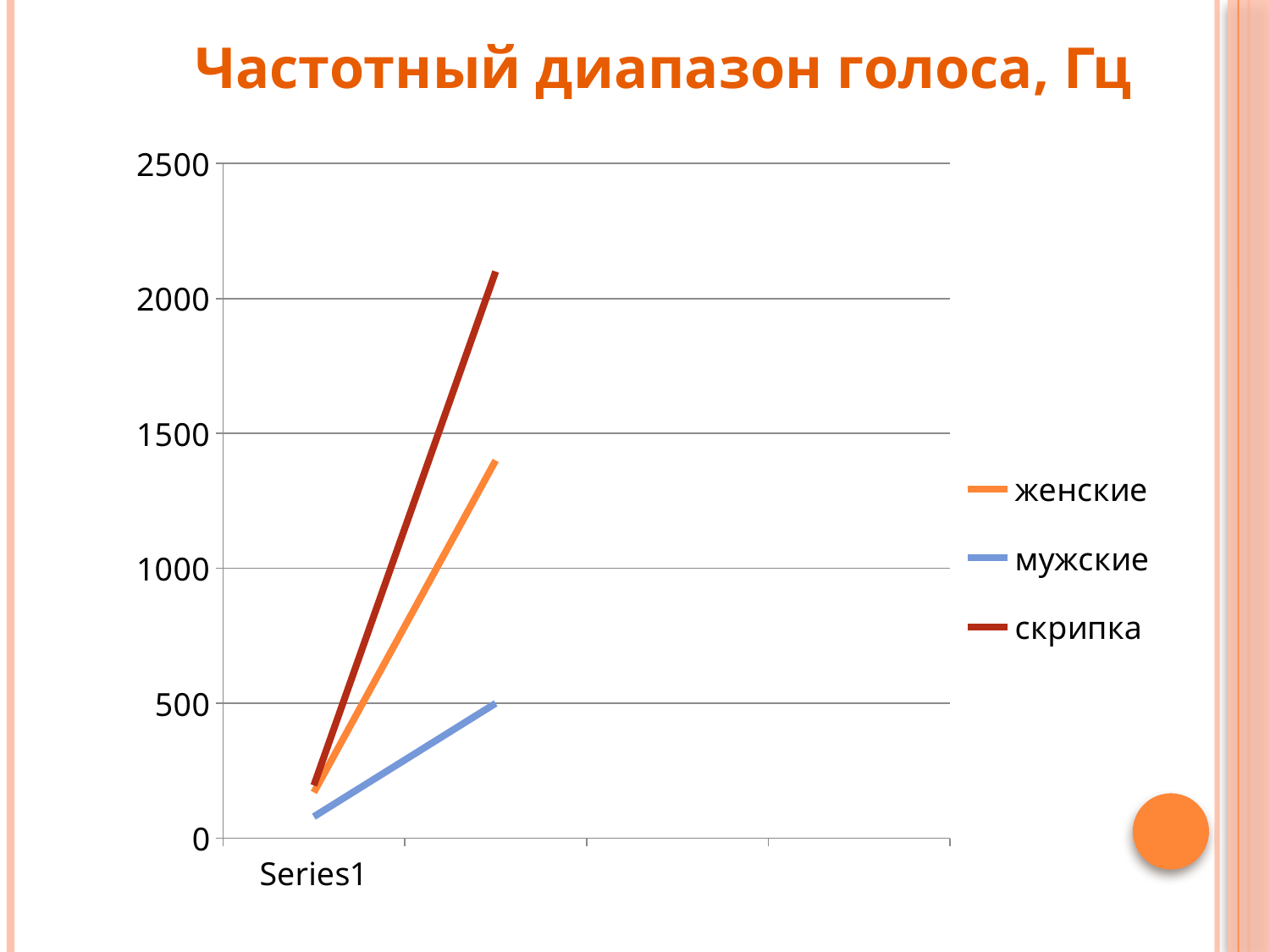
Do the lines rise or fall from left to right? rise What colour is the line for мужские in the legend? blue Is the highest value of the скрипка line greater or less than 2000? greater How many series does the legend list? 3 Which series has the lowest values on the chart? мужские Is the highest value of the мужские line greater or less than 1000? less Is the starting value of the скрипка line greater or less than 500? less Which series reaches the highest value on the chart? скрипка Which line reaches a higher value, женские or мужские? женские What is the title of the chart? Частотный диапазон голоса, Гц What kind of chart is shown on the slide? line chart